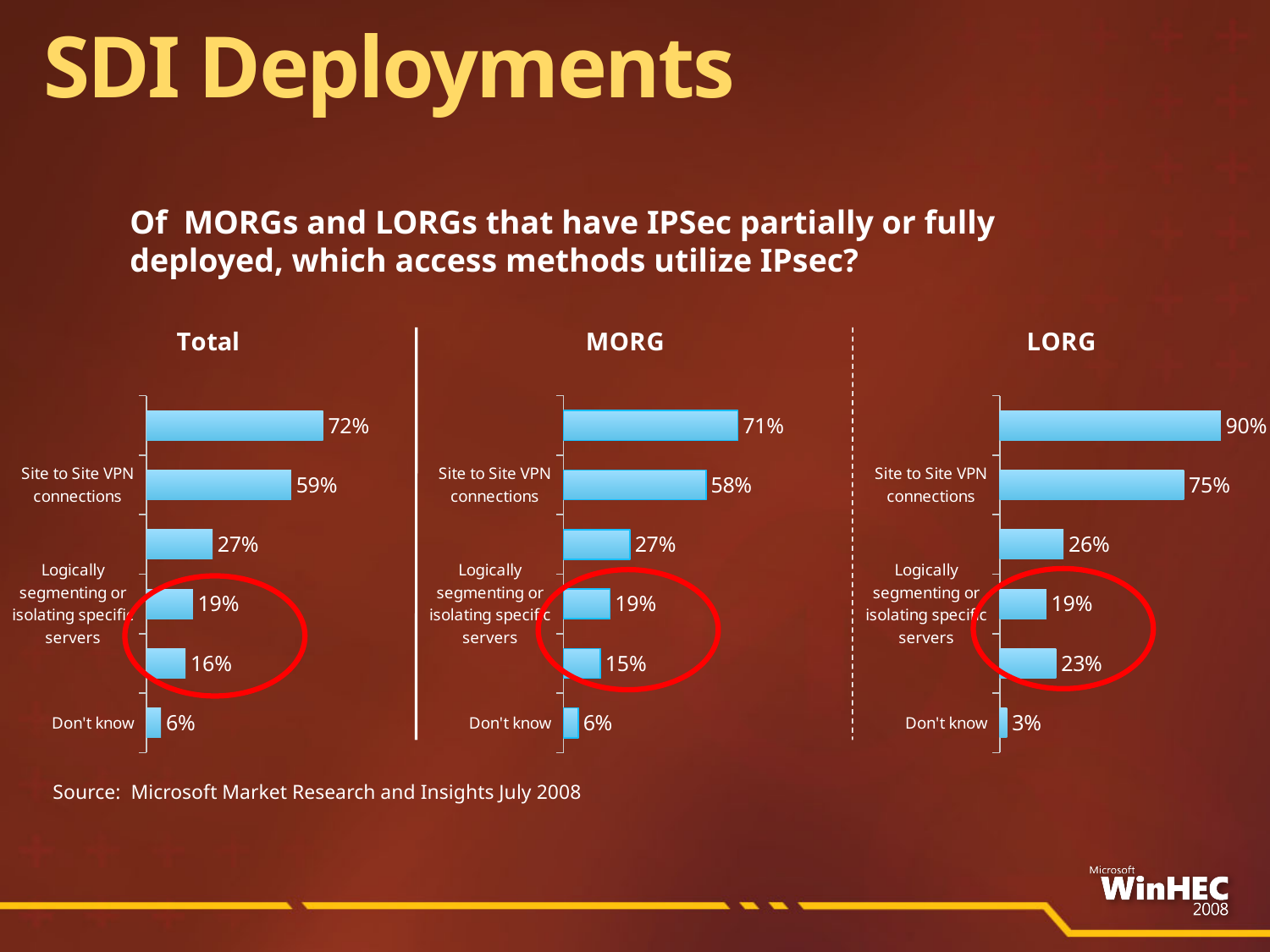
In the Total chart, what is the value for Logically segmenting or isolating specific servers? 19% In the Total chart, what is the value for Site to Site VPN connections? 59% What type of chart is used for the Total, MORG and LORG panels? Bar chart How many bars does the Total chart contain? 6 In the LORG chart, what is the value for Don't know? 3% In the Total chart, what is the difference between Site to Site VPN connections and Logically segmenting or isolating specific servers? 40% In the MORG chart, what is the value for Don't know? 6% In the LORG chart, which labeled category has the lowest value? Don't know In the LORG chart, what is the difference between Site to Site VPN connections and Don't know? 72% Is the value for Site to Site VPN connections larger in the MORG chart or the LORG chart? LORG In the MORG chart, what is the value for Site to Site VPN connections? 58% In the LORG chart, what is the value for Site to Site VPN connections? 75%